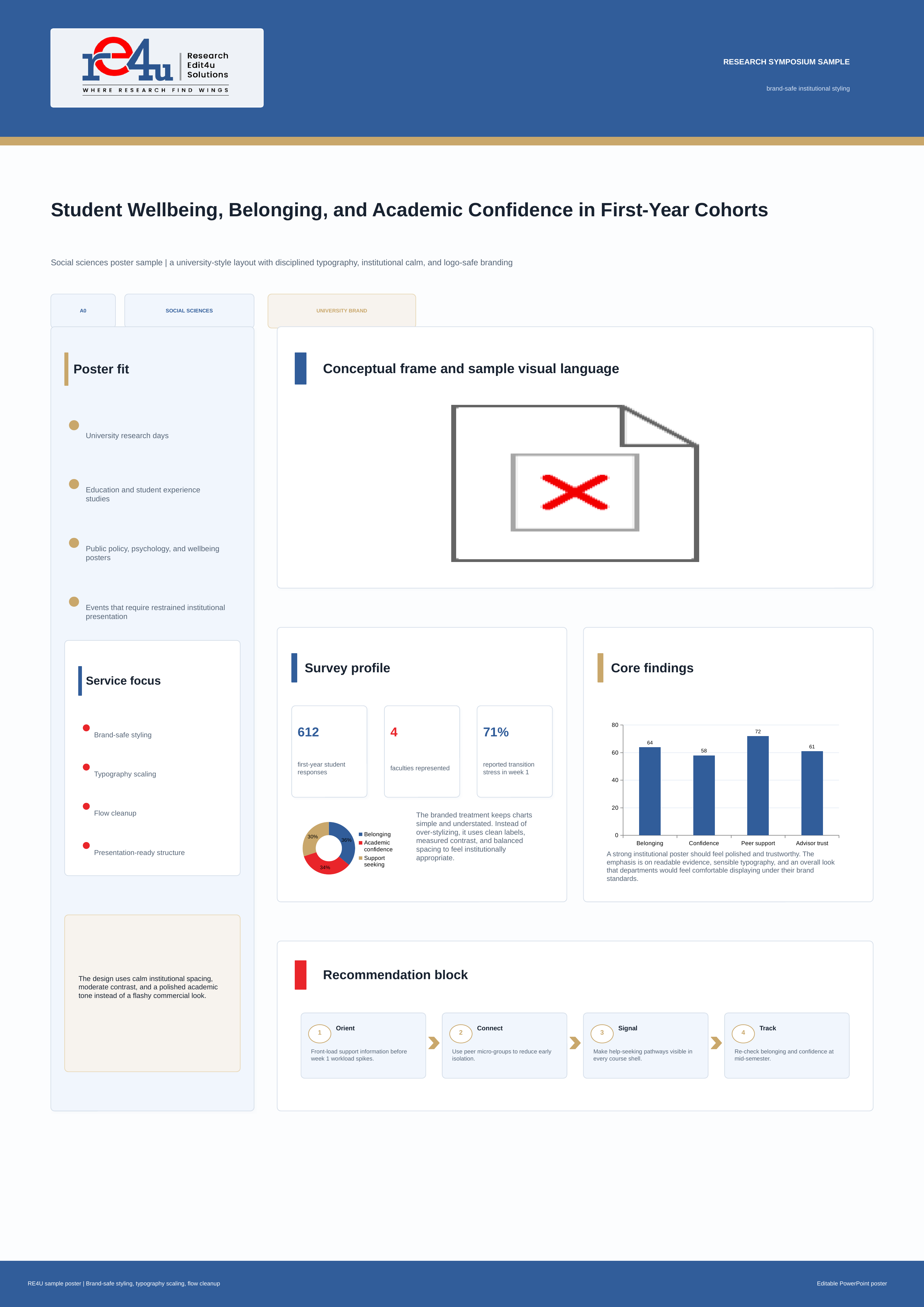
In the doughnut chart in the Survey profile section, which slice is the largest? Belonging In the doughnut chart in the Survey profile section, what share does Academic confidence have? 34% How many categories are shown in the bar chart in the Core findings section? 4 In the bar chart in the Core findings section, is the value for Advisor trust greater or less than 60? greater In the bar chart in the Core findings section, what is the value for Confidence? 58 In the bar chart in the Core findings section, which category has the lowest value? Confidence In the bar chart in the Core findings section, what is the value for Peer support? 72 In the bar chart in the Core findings section, which category has the highest value? Peer support How many entries does the legend of the doughnut chart in the Survey profile section list? 3 In the bar chart in the Core findings section, which is larger, the value for Belonging or the value for Advisor trust? Belonging What kind of chart is shown in the Core findings section? bar chart In the bar chart in the Core findings section, what is the difference between the values for Peer support and Confidence? 14